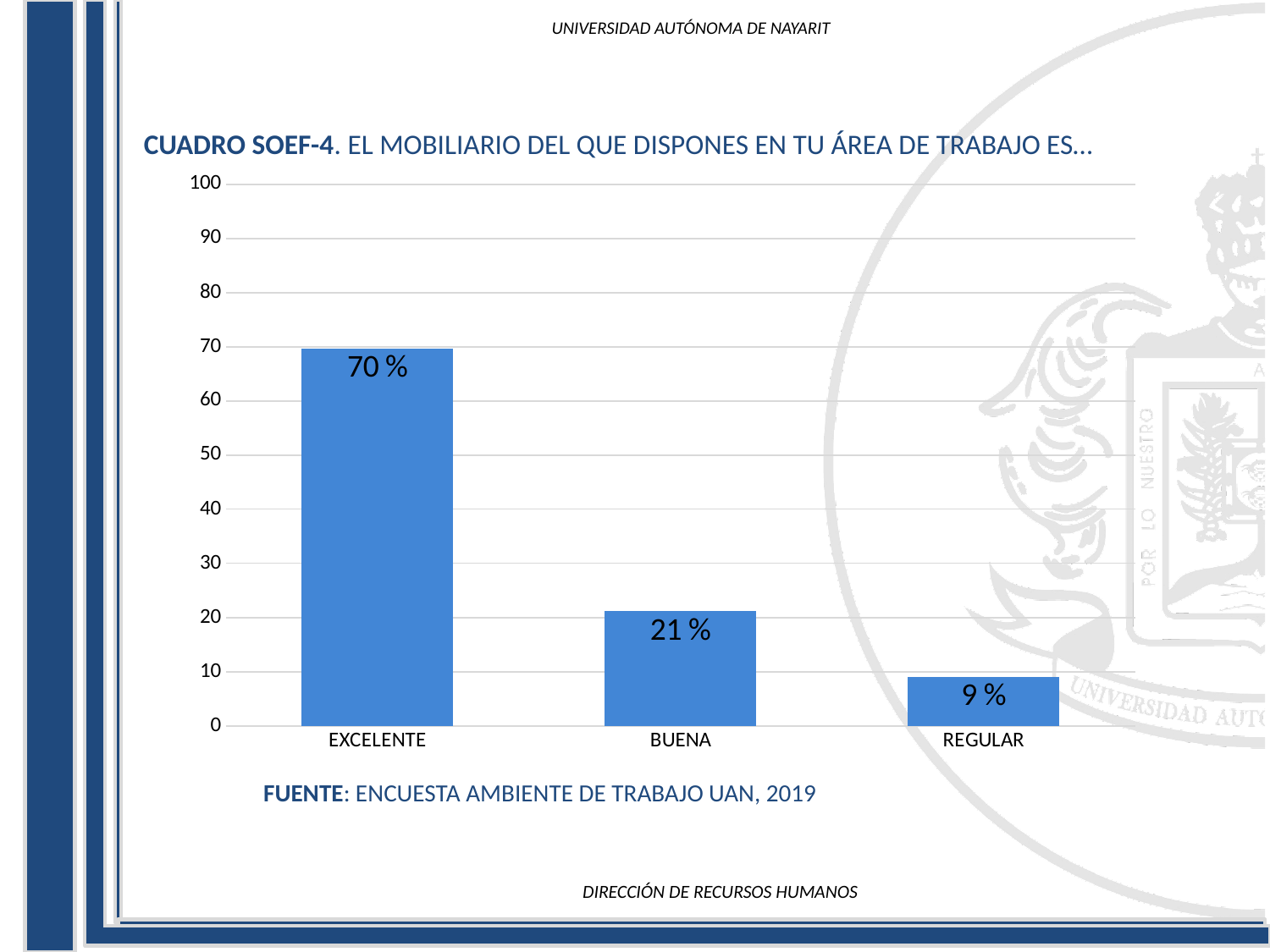
Is the value for BUENA greater or less than 30? less What is the value for REGULAR? 9 % What kind of chart is shown on the slide? bar chart What is the value for EXCELENTE? 70 % Which category has the highest value? EXCELENTE Do the values rise or fall from left to right along the x axis? fall What is the difference between the values for EXCELENTE and BUENA? 49 % Which is larger, the value for BUENA or the value for REGULAR? BUENA What is the value for BUENA? 21 % How many categories are shown on the x axis? 3 What is the difference between the values for BUENA and REGULAR? 12 % Which category has the lowest value? REGULAR